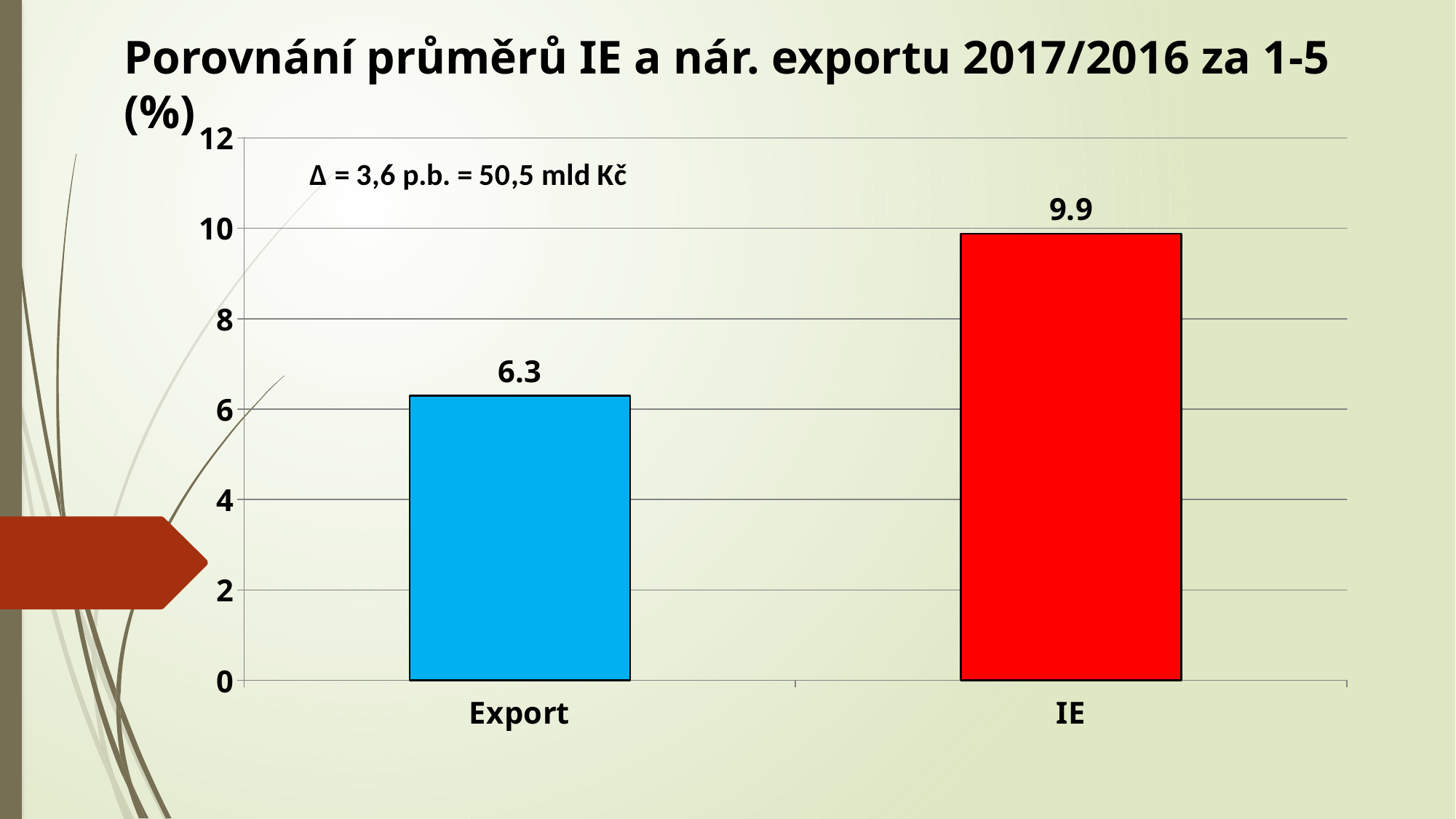
What is the highest value shown on the y axis? 12 What is the value for Export? 6.3 How many categories are shown on the x axis? 2 Which is larger, the value for Export or the value for IE? IE Is the value for Export greater or less than 8? less Is the value for IE greater or less than 8? greater Which category has the highest value? IE What is the value for IE? 9.9 What colour is the bar for IE? red What kind of chart is shown on the slide? bar chart What is the difference between the values for IE and Export? 3.6 Which category has the lowest value? Export